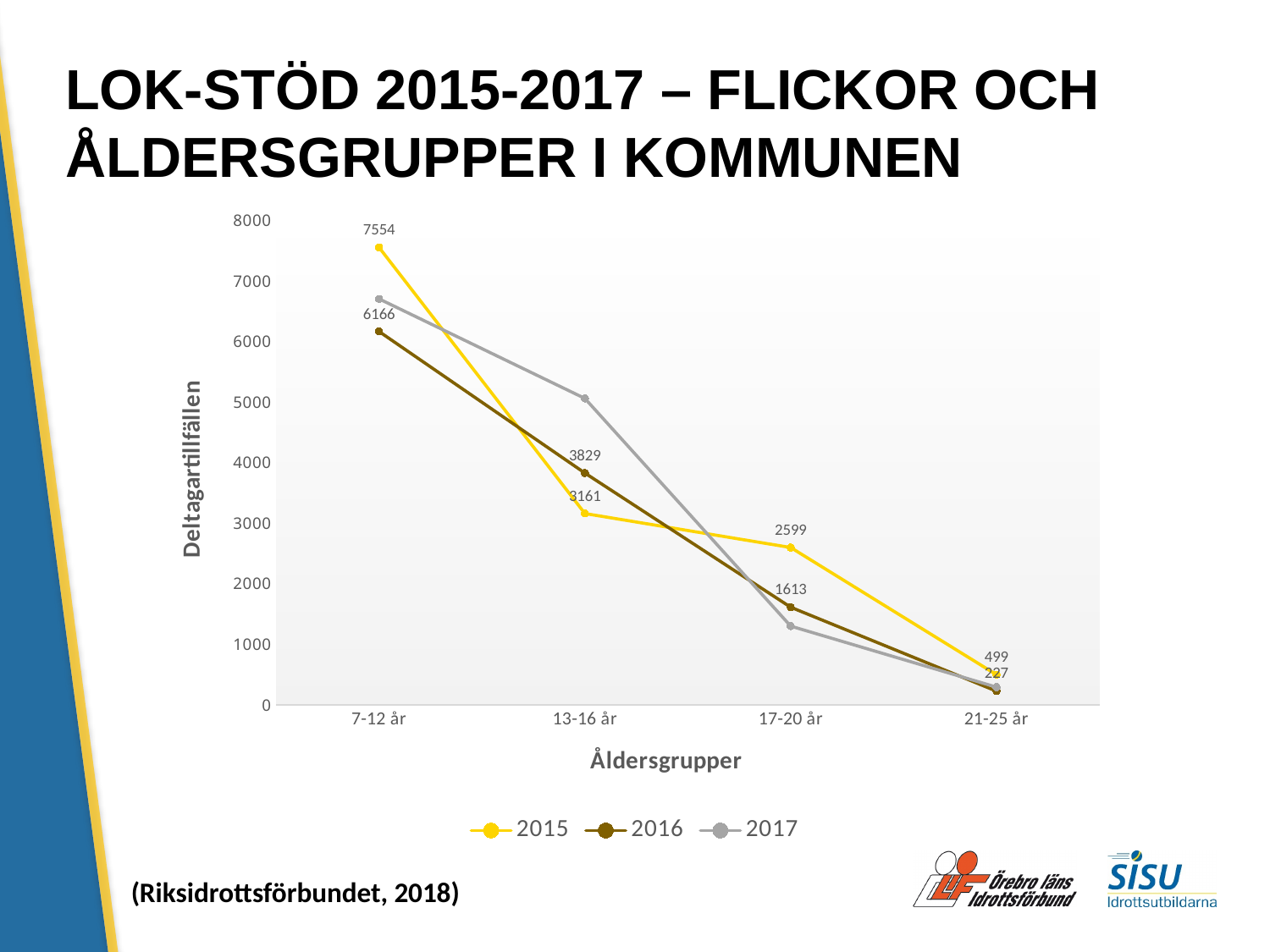
What is the value for 2015 in the 7-12 år age group? 7554 What is the value for 2015 in the 21-25 år age group? 499 What is the difference between the 2015 and 2016 values in the 7-12 år age group? 1388 What is the value for 2016 in the 13-16 år age group? 3829 Which is larger in the 13-16 år age group, the 2015 value or the 2016 value? 2016 Which age group has the highest value for the 2015 series? 7-12 år How many age groups are shown on the x axis? 4 Which age group has the lowest value for the 2016 series? 21-25 år What is the value for 2016 in the 17-20 år age group? 1613 Is the value for 2017 in the 7-12 år age group greater or less than 6000? greater How many series does the legend list? 3 What kind of chart is shown on the slide? line chart